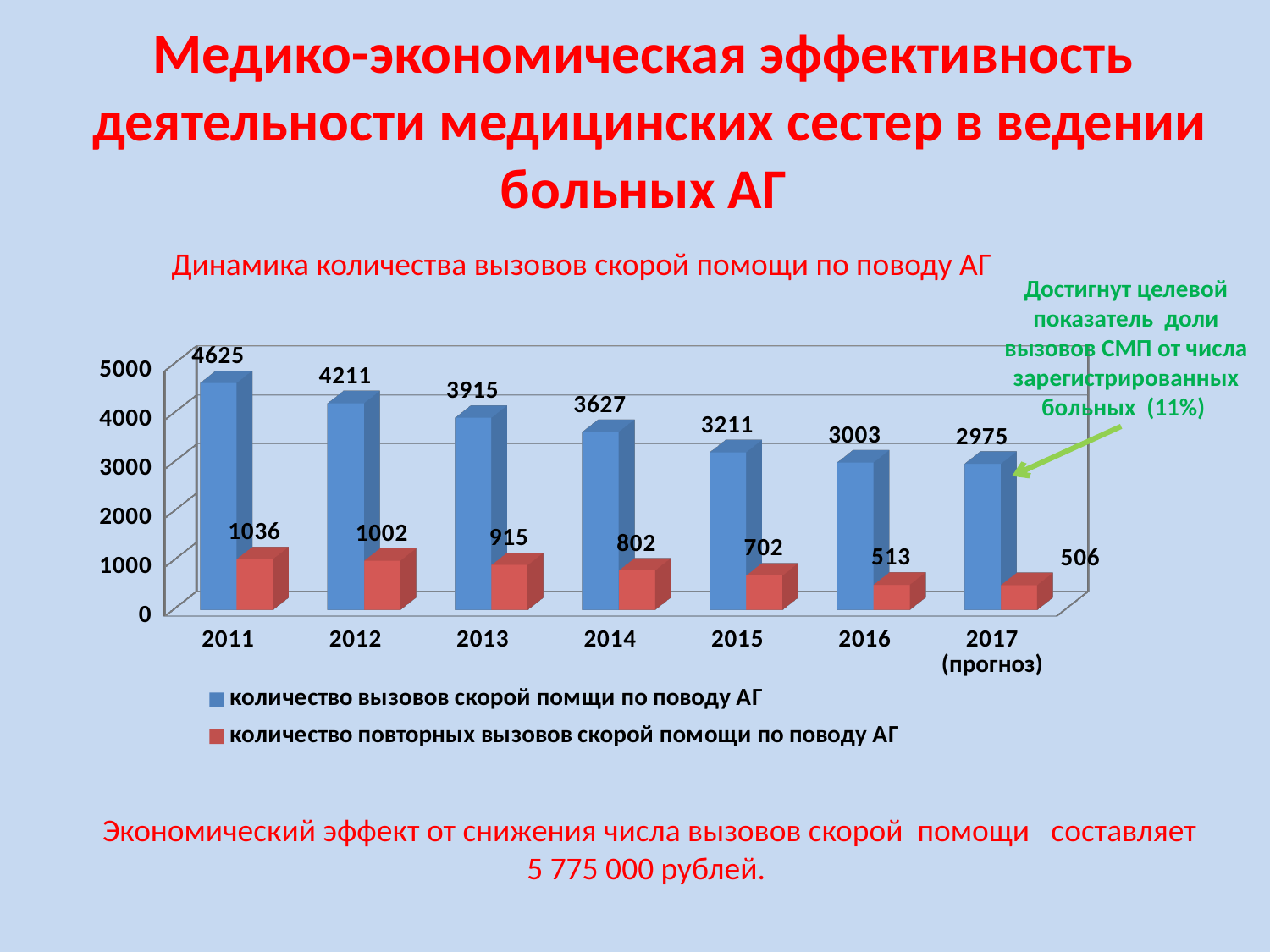
How many series does the chart legend list? 2 Do the numbers of ambulance calls for hypertension rise or fall from 2011 to 2017? fall How many years are shown on the x axis of the chart? 7 By how much did the number of ambulance calls for hypertension decrease from 2011 to 2012? 414 In which year is the number of repeat ambulance calls lowest? 2017 (прогноз) What is the forecast number of ambulance calls for hypertension in 2017 (прогноз)? 2975 In which year was the number of ambulance calls for hypertension highest? 2011 What type of chart is shown on the slide? bar chart What was the number of ambulance calls for hypertension (количество вызовов скорой помщи по поводу АГ) in 2013? 3915 Which is larger: the number of repeat calls in 2012 or in 2016? 2012 What is the difference between the number of ambulance calls and the number of repeat calls in 2014? 2825 What was the number of repeat ambulance calls for hypertension (количество повторных вызовов) in 2015? 702